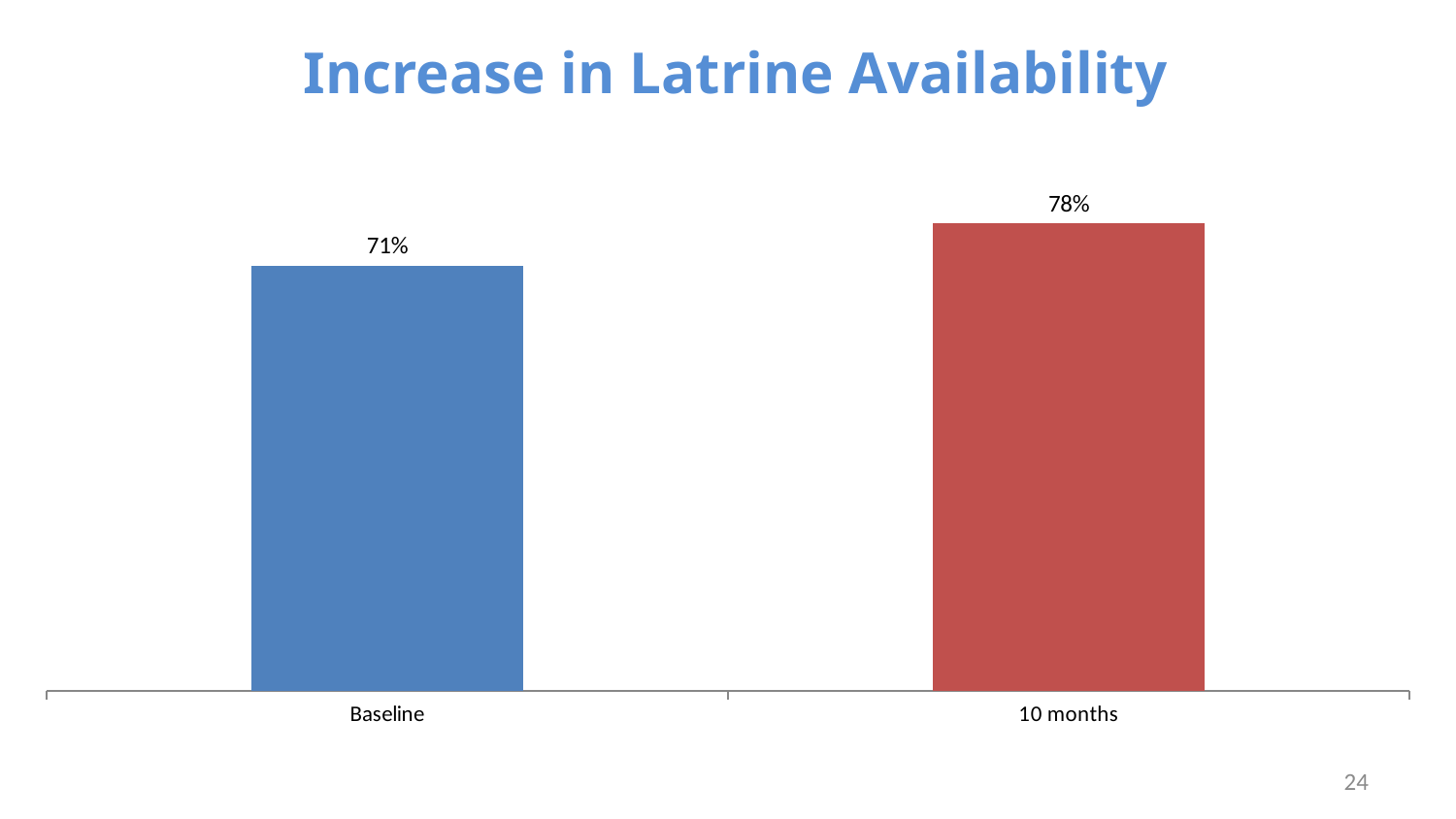
Which is larger, the value for Baseline or the value for 10 months? 10 months What is the difference between the 10 months value and the Baseline value? 7% Do the values rise or fall from Baseline to 10 months? Rise What is the title of the chart? Increase in Latrine Availability What is the value for Baseline? 71% What kind of chart is shown on the slide? Bar chart What is the value for 10 months? 78% How many categories are shown on the chart? 2 Which category has the highest value? 10 months What colour is the bar for 10 months? Red Which category has the lowest value? Baseline